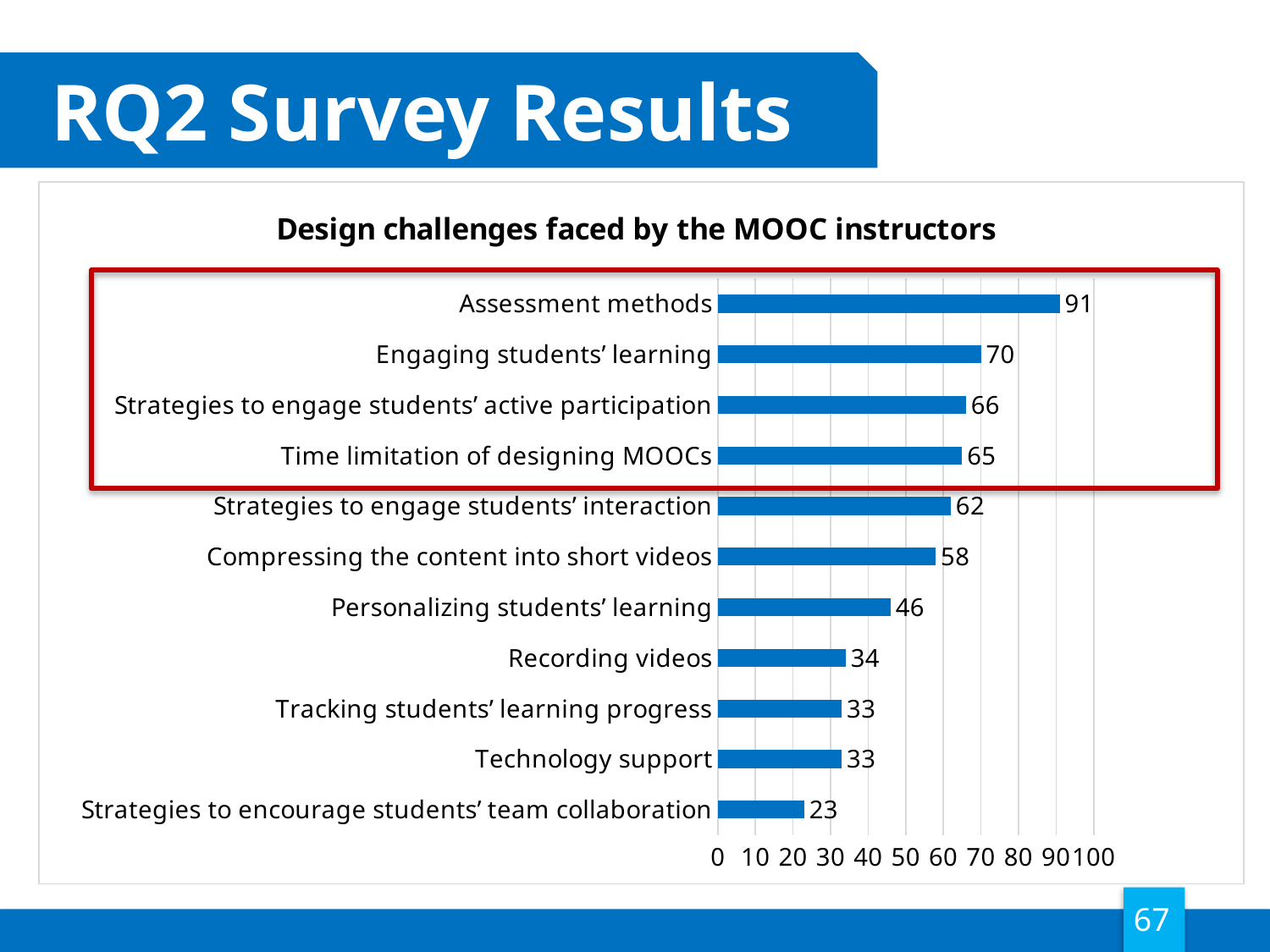
What is the value for Time limitation of designing MOOCs? 65 What is the title of the chart? Design challenges faced by the MOOC instructors Which is larger, the value for Recording videos or the value for Compressing the content into short videos? Compressing the content into short videos Which design challenge has the highest value? Assessment methods What is the difference between the values for Assessment methods and Engaging students' learning? 21 What kind of chart is shown on the slide? Bar chart Which design challenge has the lowest value? Strategies to encourage students' team collaboration What is the value for Assessment methods? 91 How many design challenges are shown in the chart? 11 What is the value for Personalizing students' learning? 46 What is the difference between the values for Strategies to engage students' interaction and Strategies to encourage students' team collaboration? 39 How many design challenges are enclosed in the red box? 4